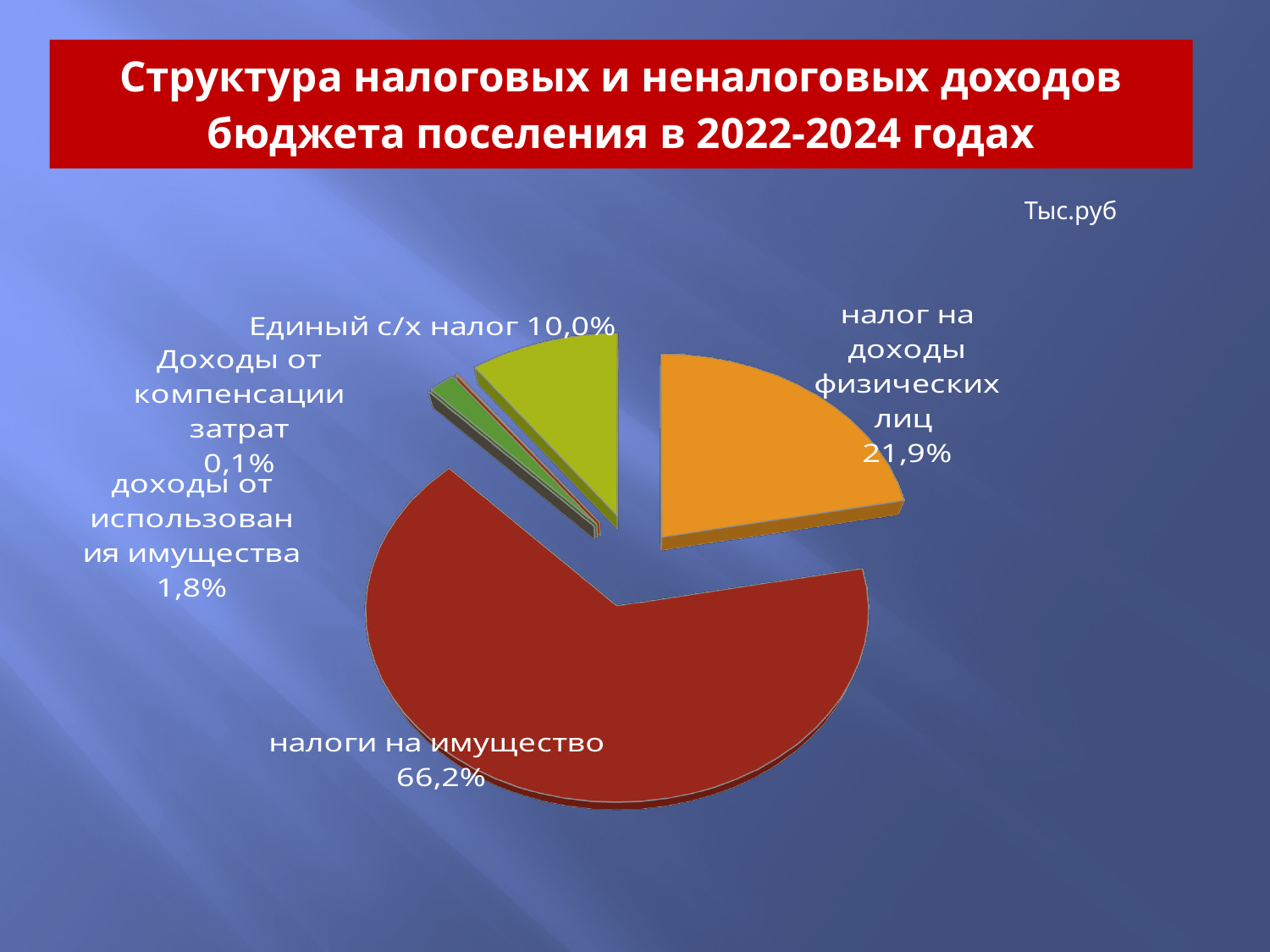
What share is shown for "доходы от использования имущества"? 1,8% What share is shown for "налог на доходы физических лиц"? 21,9% What share of the pie does "налоги на имущество" have? 66,2% Which slice of the pie is the largest? налоги на имущество What is the difference in percentage points between "налоги на имущество" and "налог на доходы физических лиц"? 44,3 What share is shown for "Единый с/х налог"? 10,0% Which is larger: "Единый с/х налог" or "доходы от использования имущества"? Единый с/х налог What kind of chart is shown on the slide? pie chart How many slices does the pie chart have? 6 What share is shown for "Доходы от компенсации затрат"? 0,1% What colour is the slice for "налог на доходы физических лиц"? orange